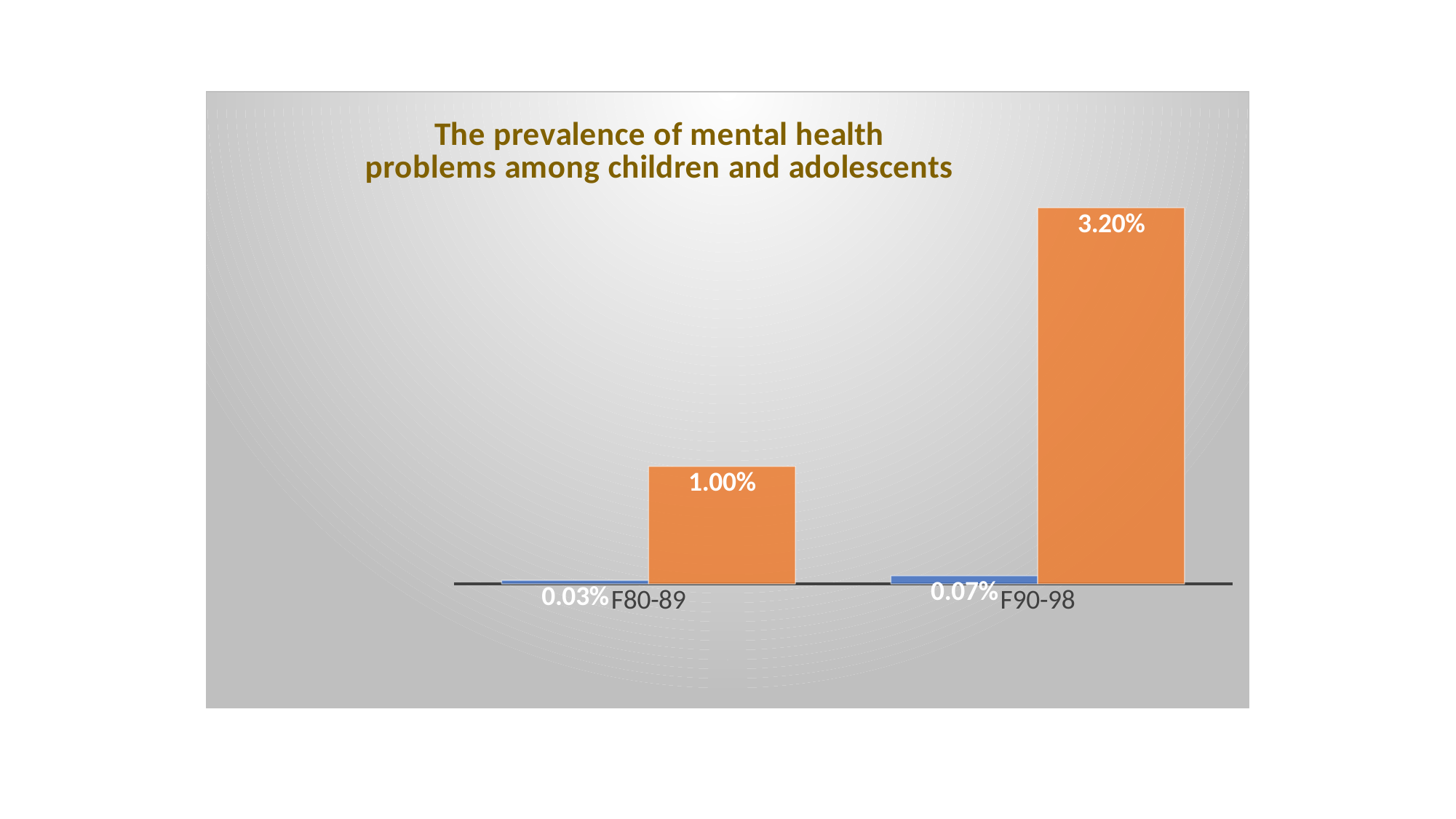
What is the value of the orange bar for F80-89? 1.00% What is the title of the chart? The prevalence of mental health problems among children and adolescents Which is larger: the orange bar for F80-89 or the orange bar for F90-98? F90-98 What is the value of the blue bar for F80-89? 0.03% How many categories are shown on the x axis? 2 What is the value of the orange bar for F90-98? 3.20% What type of chart is shown on the slide? bar chart What is the value of the blue bar for F90-98? 0.07% What is the difference between the orange bar values for F90-98 and F80-89? 2.20% How many bars are plotted for each category? 2 Which category has the lowest blue bar? F80-89 Which category has the highest orange bar? F90-98